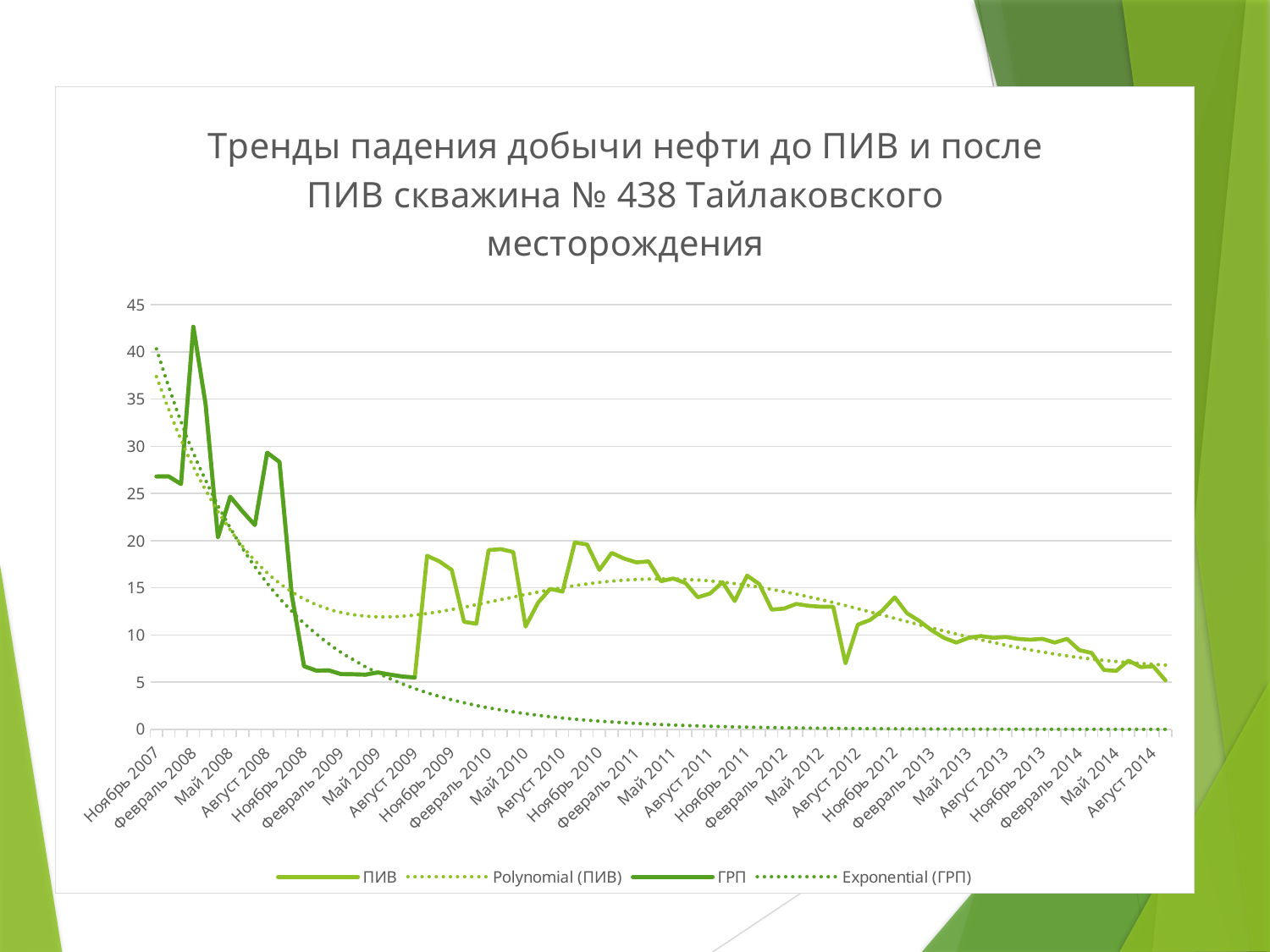
What is the first month shown on the x axis? Ноябрь 2007 Is the value of the ПИВ series at Август 2014 greater or less than 10? less Does the ПИВ series generally rise or fall from Май 2012 to Август 2014? Fall Is the value of the ГРП series at Ноябрь 2007 greater or less than 25? greater What kind of chart is shown on the slide? Line chart Is the value of the ГРП series at Ноябрь 2008 greater or less than 10? less What are the four entries in the chart legend? ПИВ, Polynomial (ПИВ), ГРП, Exponential (ГРП) How many series does the legend list? 4